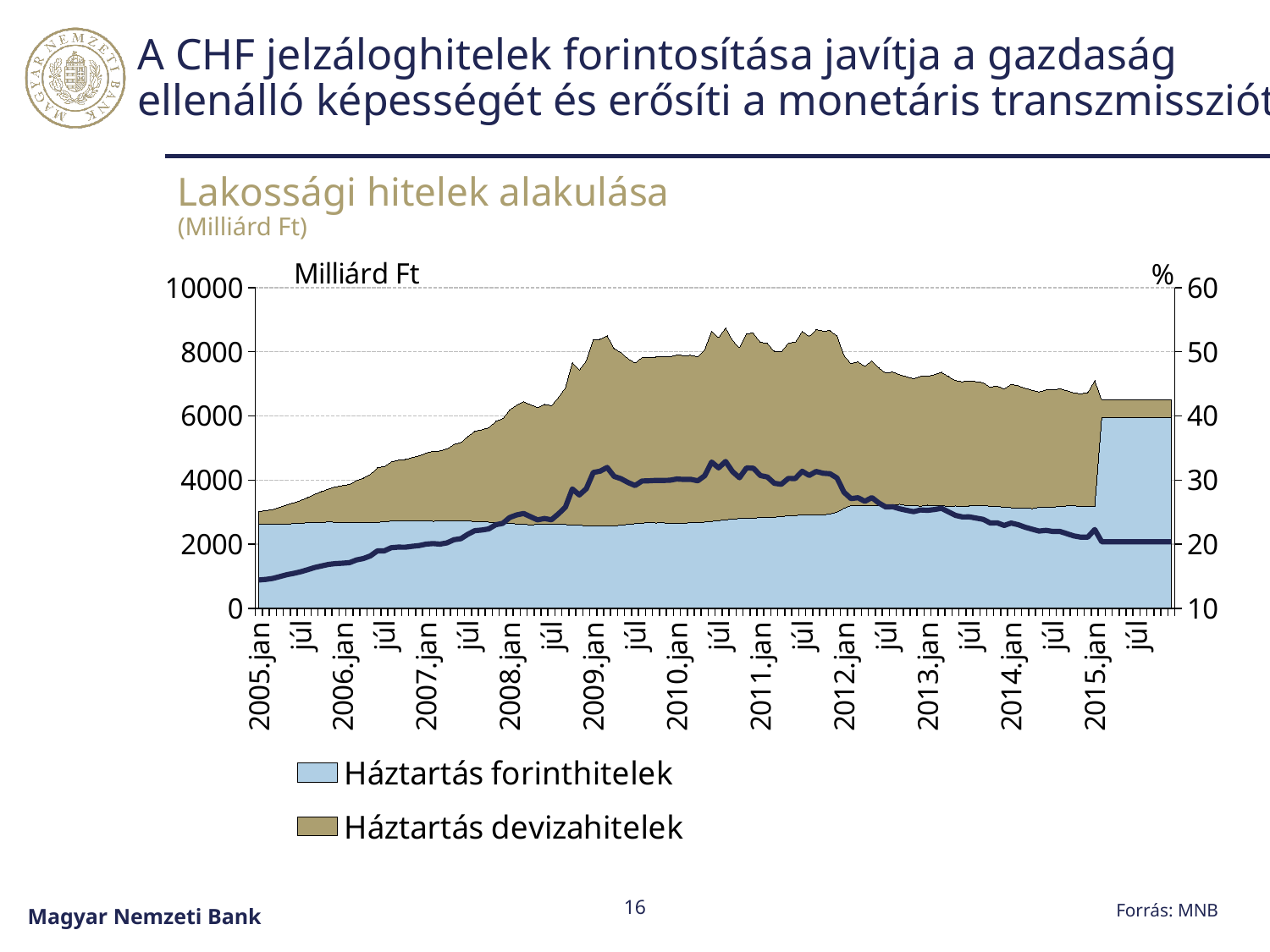
Which is larger: Háztartás forinthitelek in 2015.júl or in 2005.jan? 2015.júl Which colour represents Háztartás forinthitelek in the chart? light blue Is the value for Háztartás forinthitelek in 2010.jan greater or less than 4000? less Is the value for Háztartás forinthitelek in 2015.júl greater or less than 4000? greater What kind of chart is shown on the slide? combination area and line chart Is the total of the stacked areas in 2005.jan greater or less than 4000? less How many series does the legend list? 2 Does the dark line (right axis, %) rise or fall between 2012.jan and 2015.jan? fall What is the title of the chart? Lakossági hitelek alakulása Does the dark line (right axis, %) rise or fall between 2005.jan and 2009.jan? rise